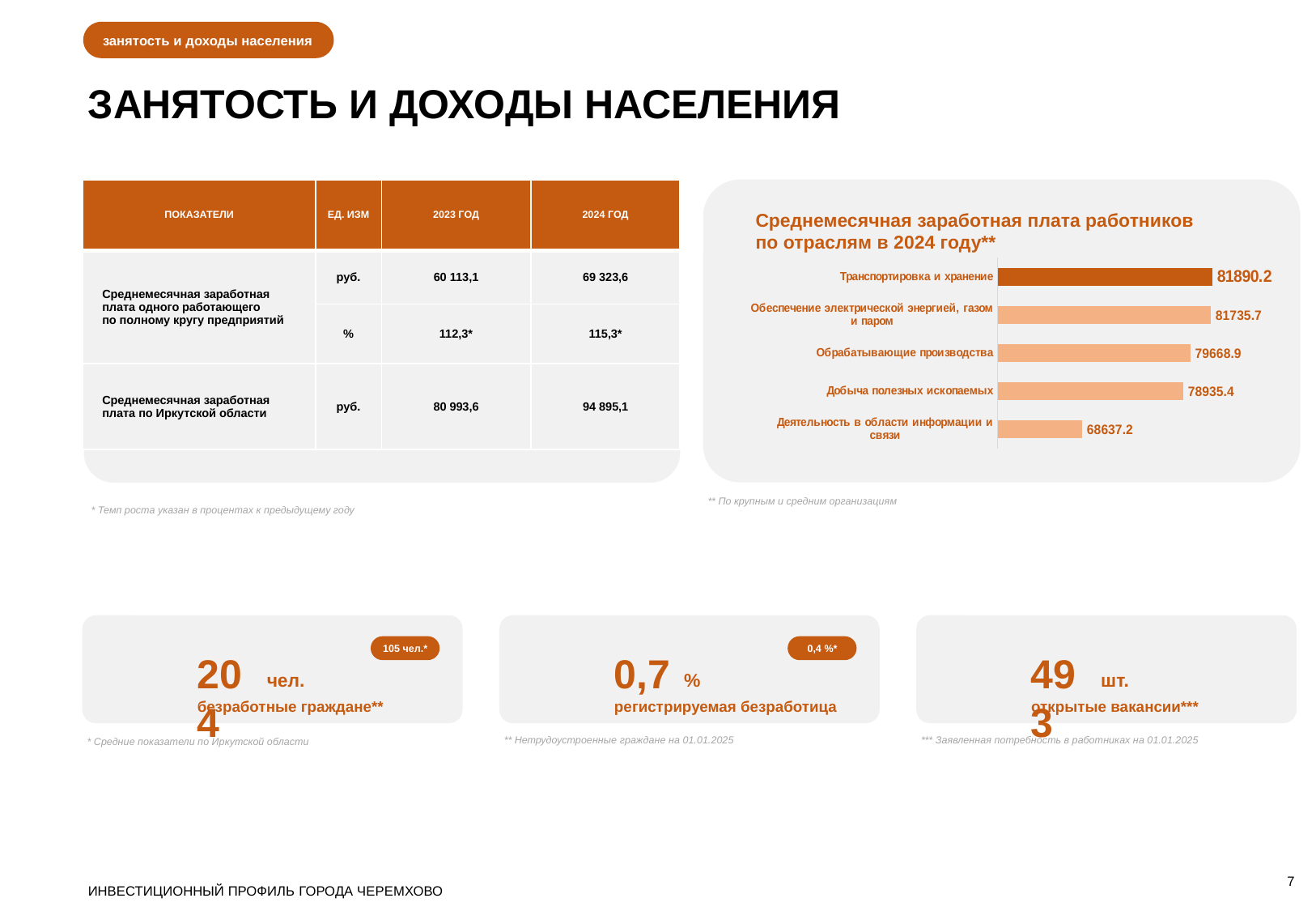
What is the title of the bar chart? Среднемесячная заработная плата работников по отраслям в 2024 году** What is the difference between the values for Обрабатывающие производства and Добыча полезных ископаемых? 733.5 What is the difference between the values for Транспортировка и хранение and Деятельность в области информации и связи? 13253.0 Which industry has the highest average monthly salary in the chart? Транспортировка и хранение What type of chart is shown on the slide? bar chart What value is shown for Обрабатывающие производства? 79668.9 Which industry has the lowest average monthly salary in the chart? Деятельность в области информации и связи What is the average monthly salary for Транспортировка и хранение in the chart? 81890.2 Which is larger: the value for Обеспечение электрической энергией, газом и паром or the value for Обрабатывающие производства? Обеспечение электрической энергией, газом и паром How many industries are shown in the bar chart? 5 What value is shown for Деятельность в области информации и связи? 68637.2 What value is shown for Добыча полезных ископаемых? 78935.4